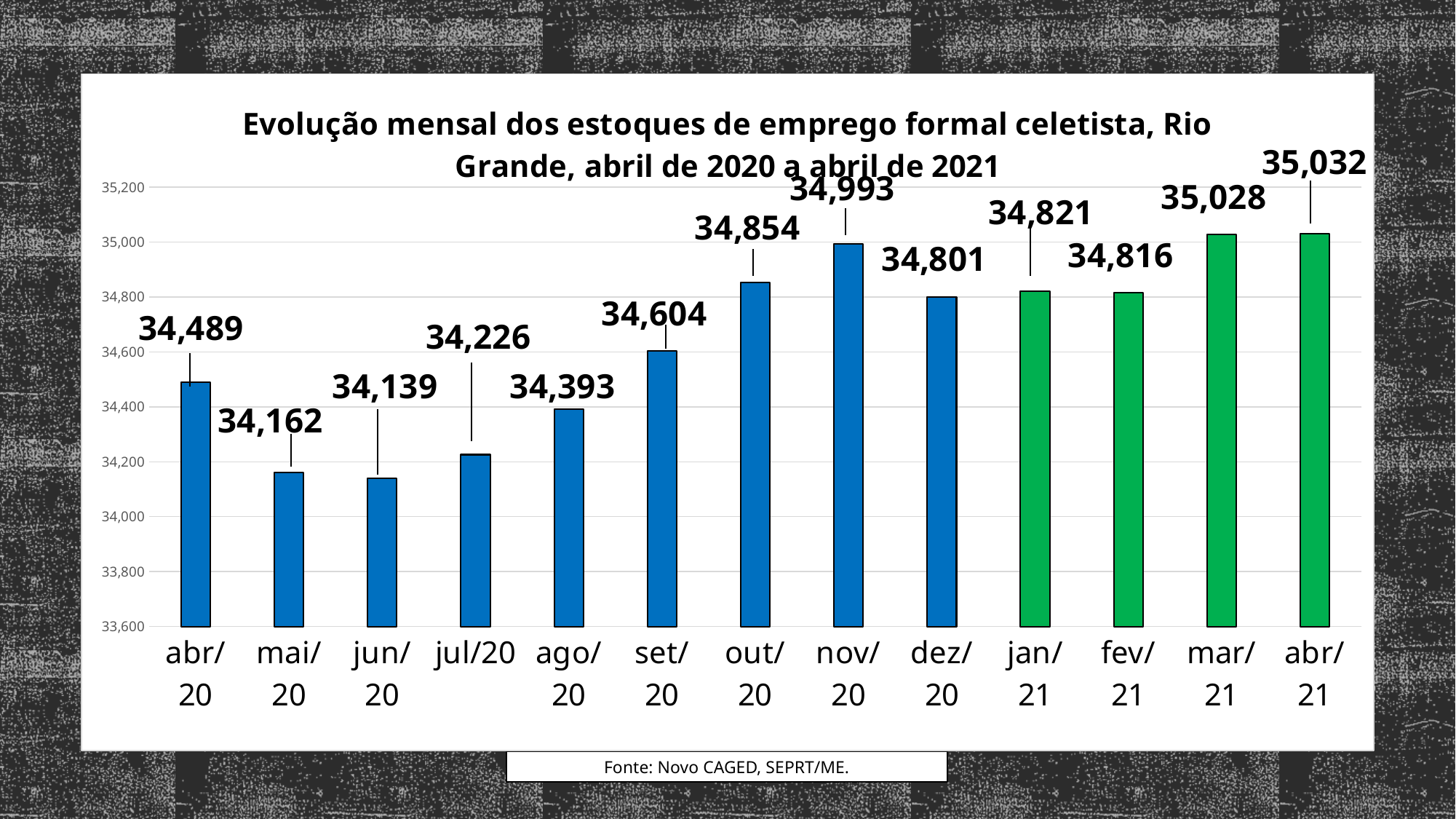
What is the difference between the values for abr/21 and abr/20? 543 Is the value for jun/20 greater or less than 34,200? less Which is larger, the value for set/20 or the value for ago/20? set/20 What is the value for nov/20? 34,993 What kind of chart is shown on the slide? bar chart Which month has the lowest value? jun/20 What is the value for jul/20? 34,226 Which month has the highest value? abr/21 What colour are the bars for the 2021 months? green Do the values generally rise or fall from abr/20 to abr/21? rise How many months are shown on the x axis? 13 What is the difference between the values for nov/20 and dez/20? 192